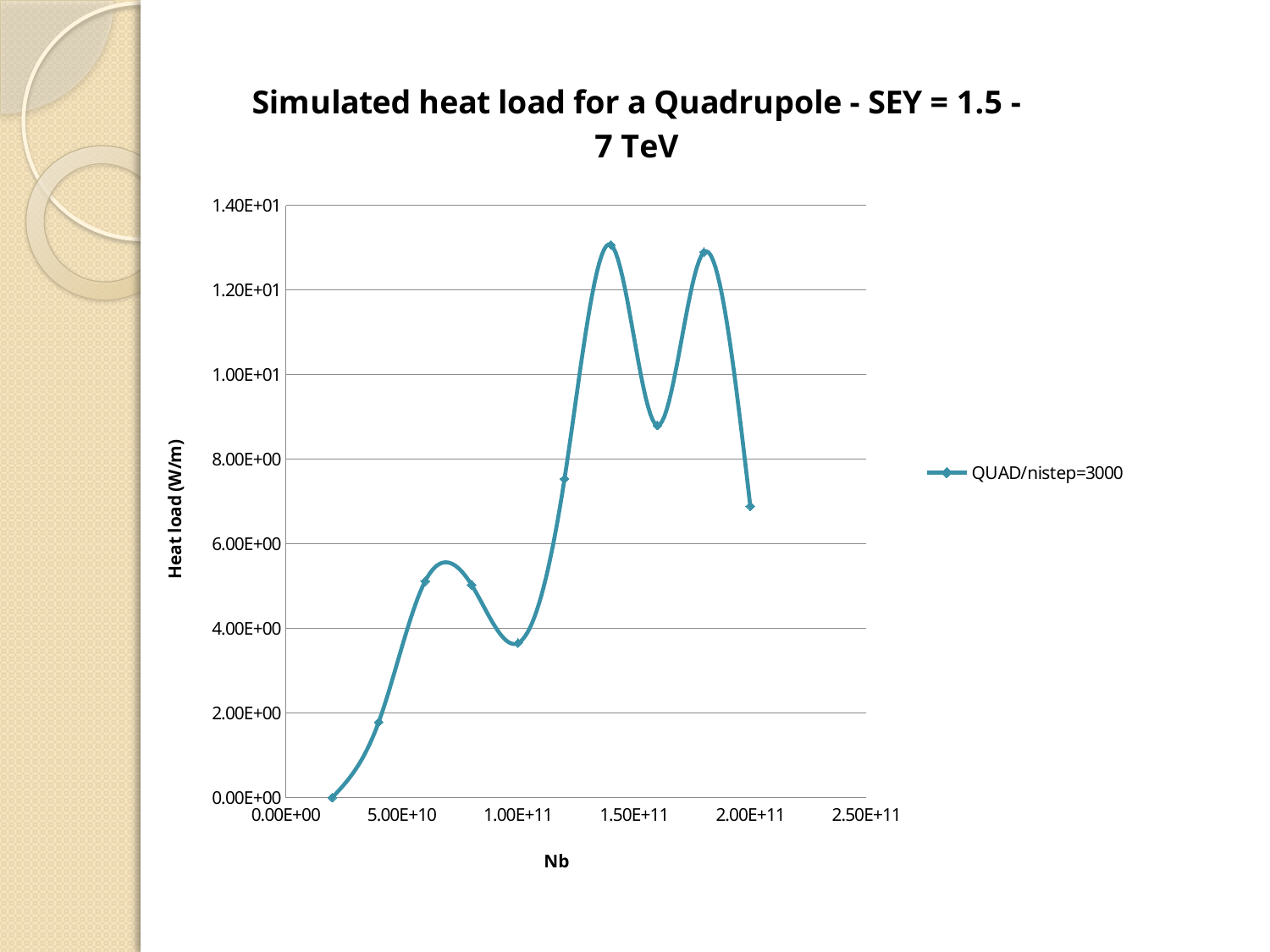
Is the heat load at Nb = 2.00E+11 greater or less than 6.00E+00? greater What is the label of the y axis? Heat load (W/m) Which y-axis tick does the lowest point on the line land on? 0.00E+00 How many series does the legend list? 1 Is the heat load at Nb = 2.00E+11 greater or less than 8.00E+00? less What kind of chart is shown on the slide? line chart What is the name of the series shown in the legend? QUAD/nistep=3000 Does the heat load rise or fall between Nb = 1.00E+11 and the next plotted point? rise Which has the larger heat load: the point at Nb = 1.00E+11 or the point at Nb = 2.00E+11? Nb = 2.00E+11 How many data points are plotted on the line? 10 Is the heat load at Nb = 1.00E+11 greater or less than 4.00E+00? less